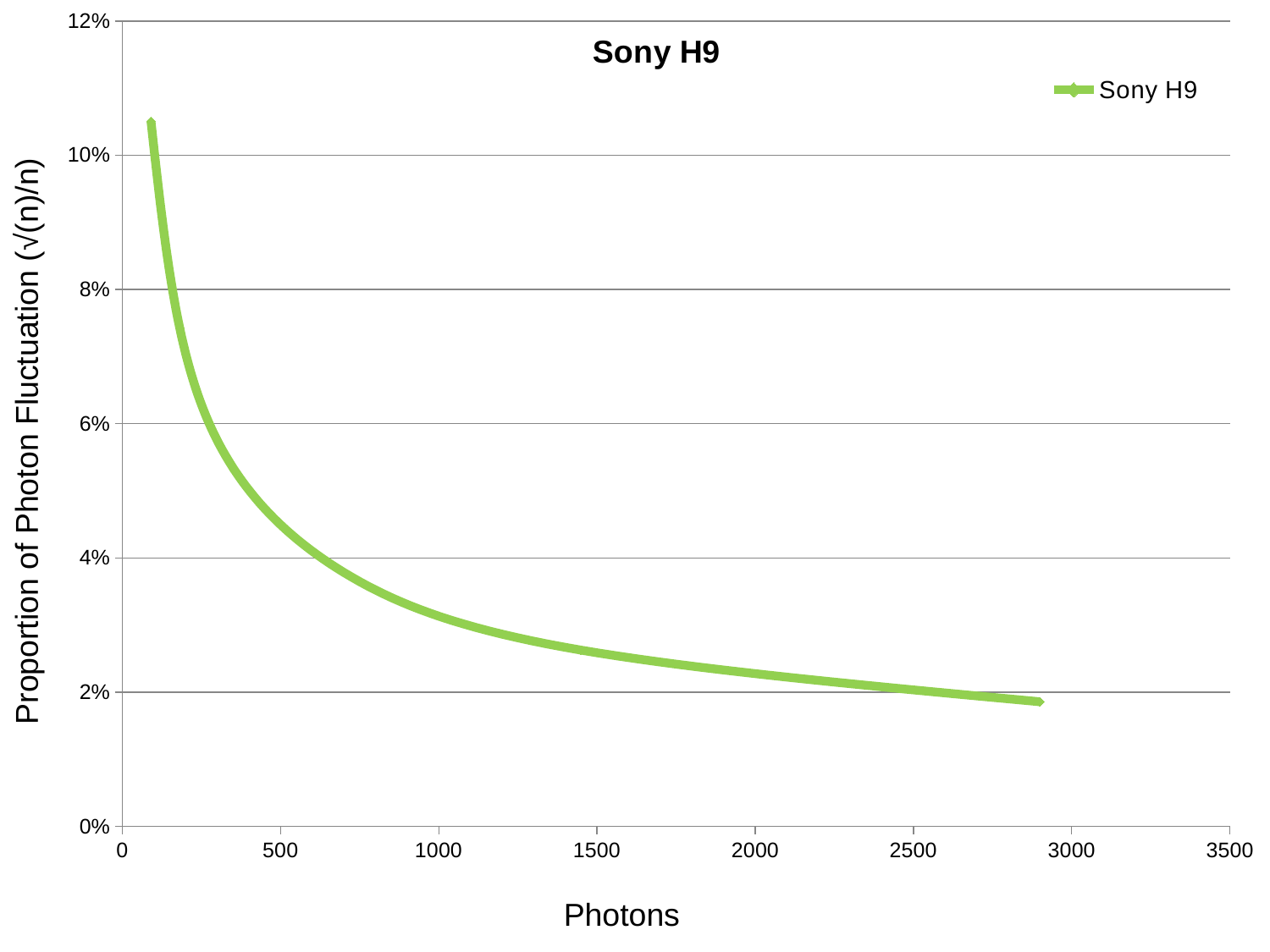
Is the value at the rightmost point of the line greater or less than 4%? less Do the values rise or fall as the number of photons increases along the x axis? fall Is the value at the leftmost point of the line greater or less than 8%? greater How many series does the legend list? 1 What is the title of the chart? Sony H9 Is the value for 1500 photons greater or less than 4%? less What kind of chart is shown on the slide? line chart What is the label of the x axis? Photons Is the value for 500 photons larger or smaller than the value for 2000 photons? larger